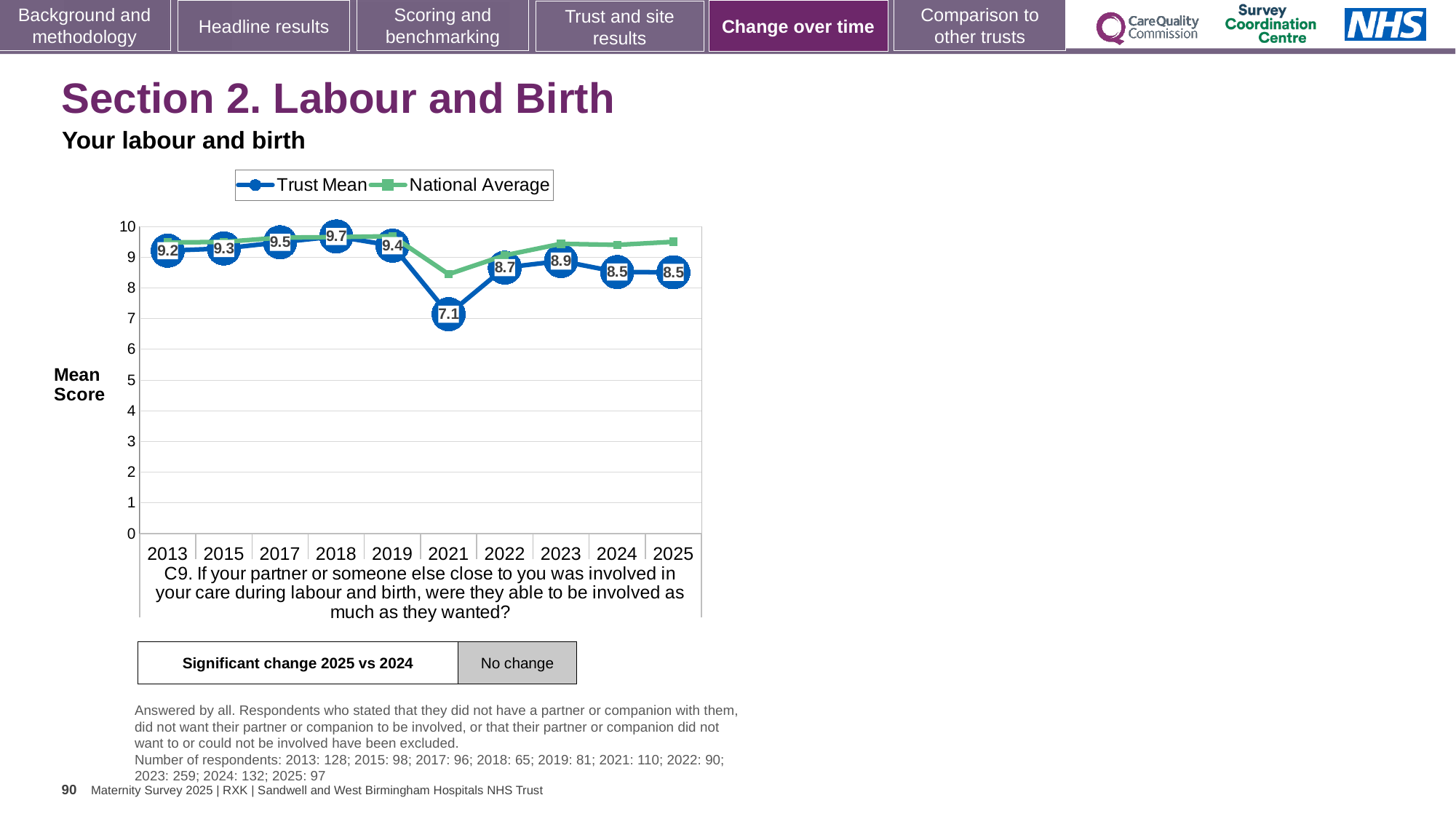
What is the difference between the Trust Mean scores for 2018 and 2021? 2.6 How many series does the legend list? 2 Is the National Average value for 2021 greater or less than 9? less What is the Trust Mean score for 2025? 8.5 In which year is the Trust Mean score highest? 2018 What kind of chart is shown on the slide? line chart How many years are shown on the x axis? 10 In which year is the Trust Mean score lowest? 2021 Does the Trust Mean score rise or fall from 2019 to 2021? fall Which is larger, the Trust Mean score for 2019 or for 2022? 2019 What is the Trust Mean score for 2013? 9.2 What is the Trust Mean score for 2021? 7.1